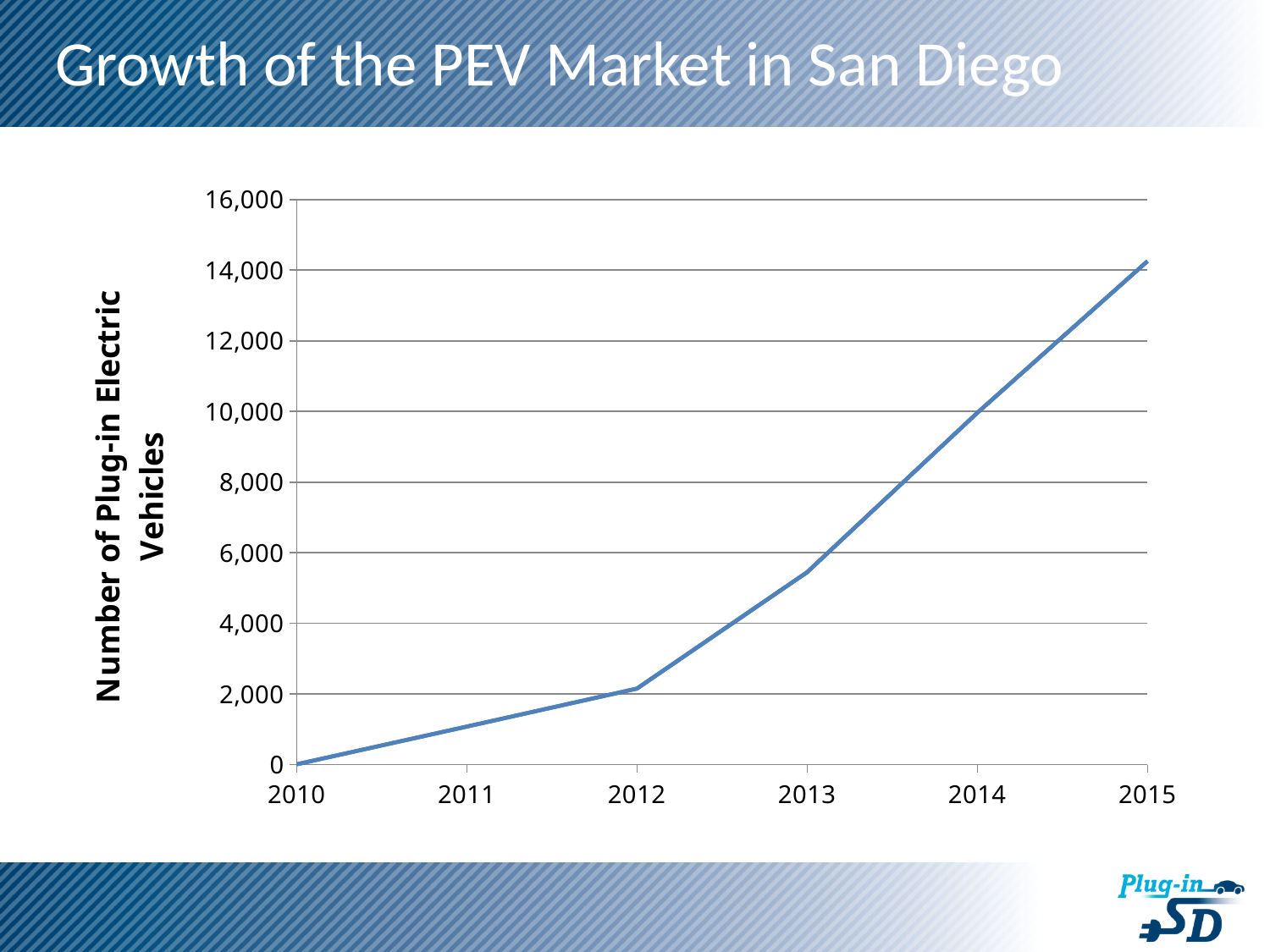
Which year has the highest number of plug-in electric vehicles? 2015 Is the value for 2014 greater or less than 8,000? greater What kind of chart is shown on the slide? line chart What is the label on the vertical axis of the chart? Number of Plug-in Electric Vehicles Which year has a larger number of plug-in electric vehicles, 2013 or 2014? 2014 Is the value for 2012 greater or less than 4,000? less Is the value for 2013 greater or less than 4,000? greater Which year has the lowest number of plug-in electric vehicles? 2010 How many years are plotted along the x axis? 6 Do the values rise or fall from 2010 to 2015? rise What is the title of the chart? Growth of the PEV Market in San Diego